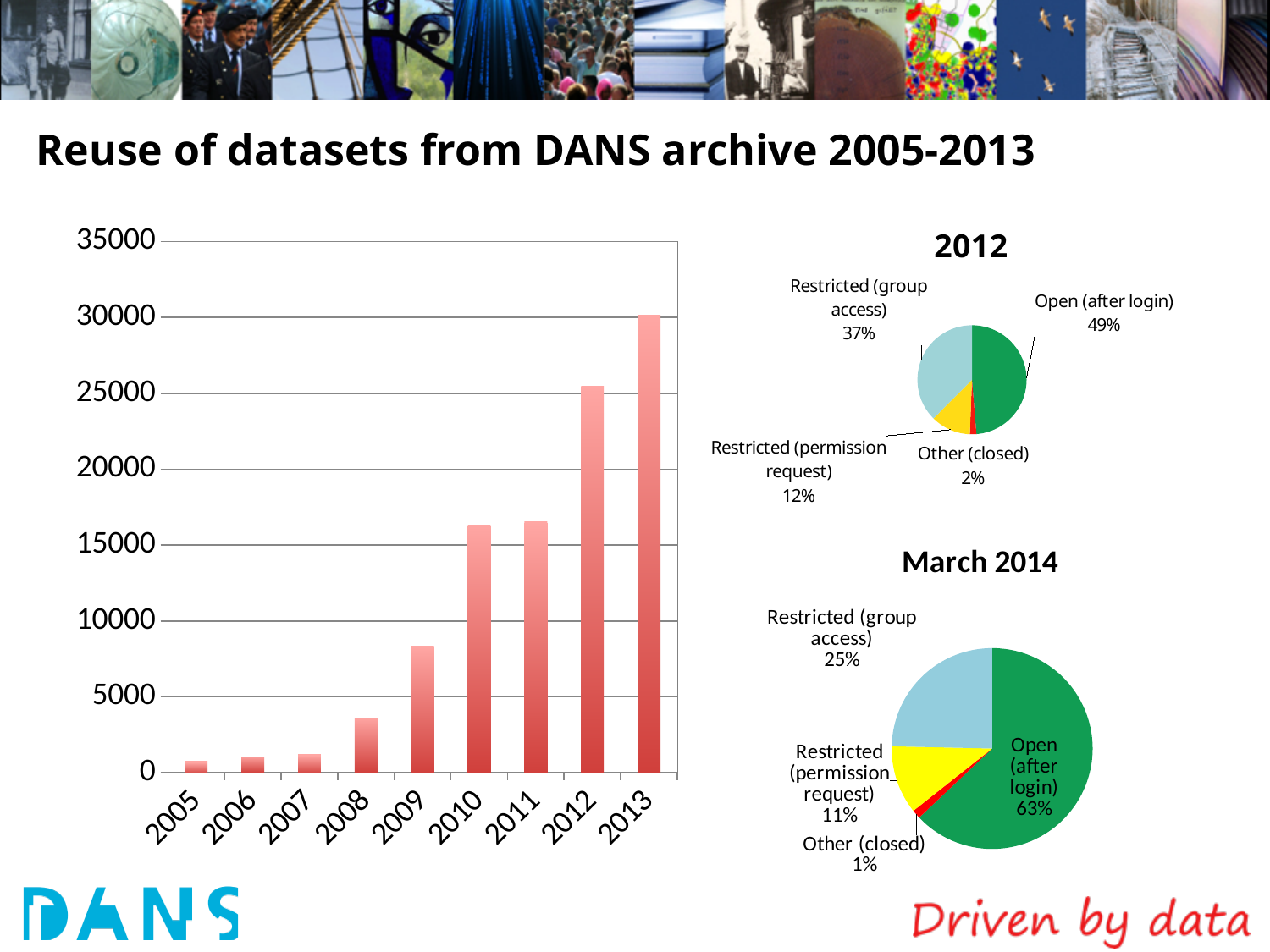
In the pie chart titled 2012, what share is Restricted (permission request)? 12% In the pie chart titled March 2014, what share is Restricted (group access)? 25% In the bar chart on the left, is the value for 2012 greater or less than 25000? greater In the bar chart on the left, which year has the lowest value? 2005 In the bar chart on the left, do the values generally rise or fall from 2005 to 2013? rise In the bar chart on the left, is the value for 2009 greater or less than 10000? less In the pie chart titled 2012, what share is Open (after login)? 49% In the bar chart on the left, which year has the highest value? 2013 What kind of chart is the chart on the left of the slide? bar chart How many years are shown on the x axis of the bar chart on the left? 9 In the pie chart titled March 2014, which category has the largest share? Open (after login)